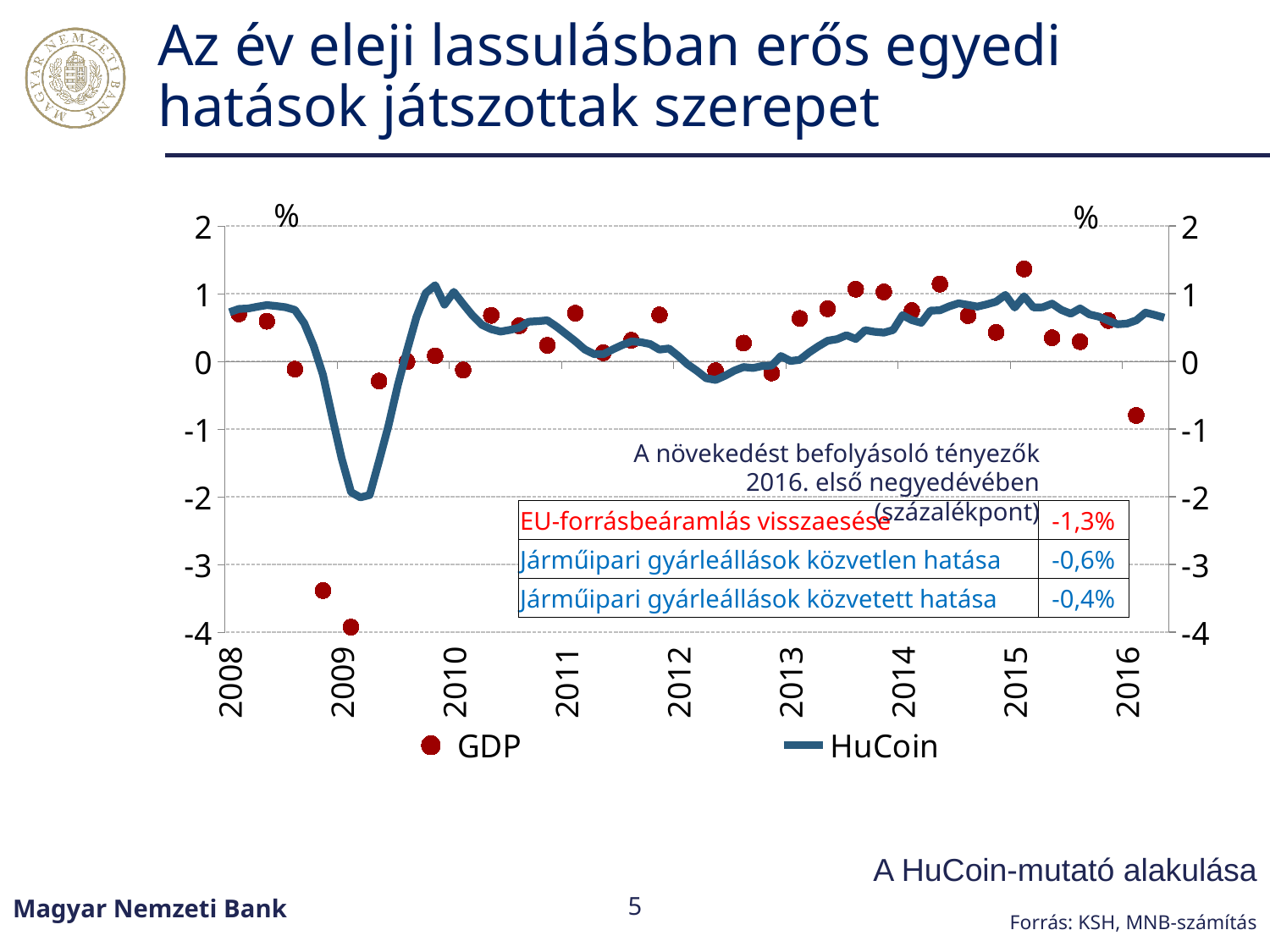
What are the two series named in the legend? GDP and HuCoin In the table on the chart, what is the value for 'Járműipari gyárleállások közvetlen hatása'? -0,6% Is the last GDP point, in 2016, greater or less than -1? greater In which year does the GDP series reach its lowest value? 2009 In the table on the chart, what is the value for 'Járműipari gyárleállások közvetett hatása'? -0,4% Does the HuCoin line rise or fall between 2012 and 2015? rise How many series does the legend list? 2 Is the lowest value of the HuCoin line, in 2009, greater or less than -1? less Is the last GDP point, in 2016, greater or less than 0? less What is the title of the chart, shown at the bottom right? A HuCoin-mutató alakulása In the table on the chart, what is the value for 'EU-forrásbeáramlás visszaesése'? -1,3%